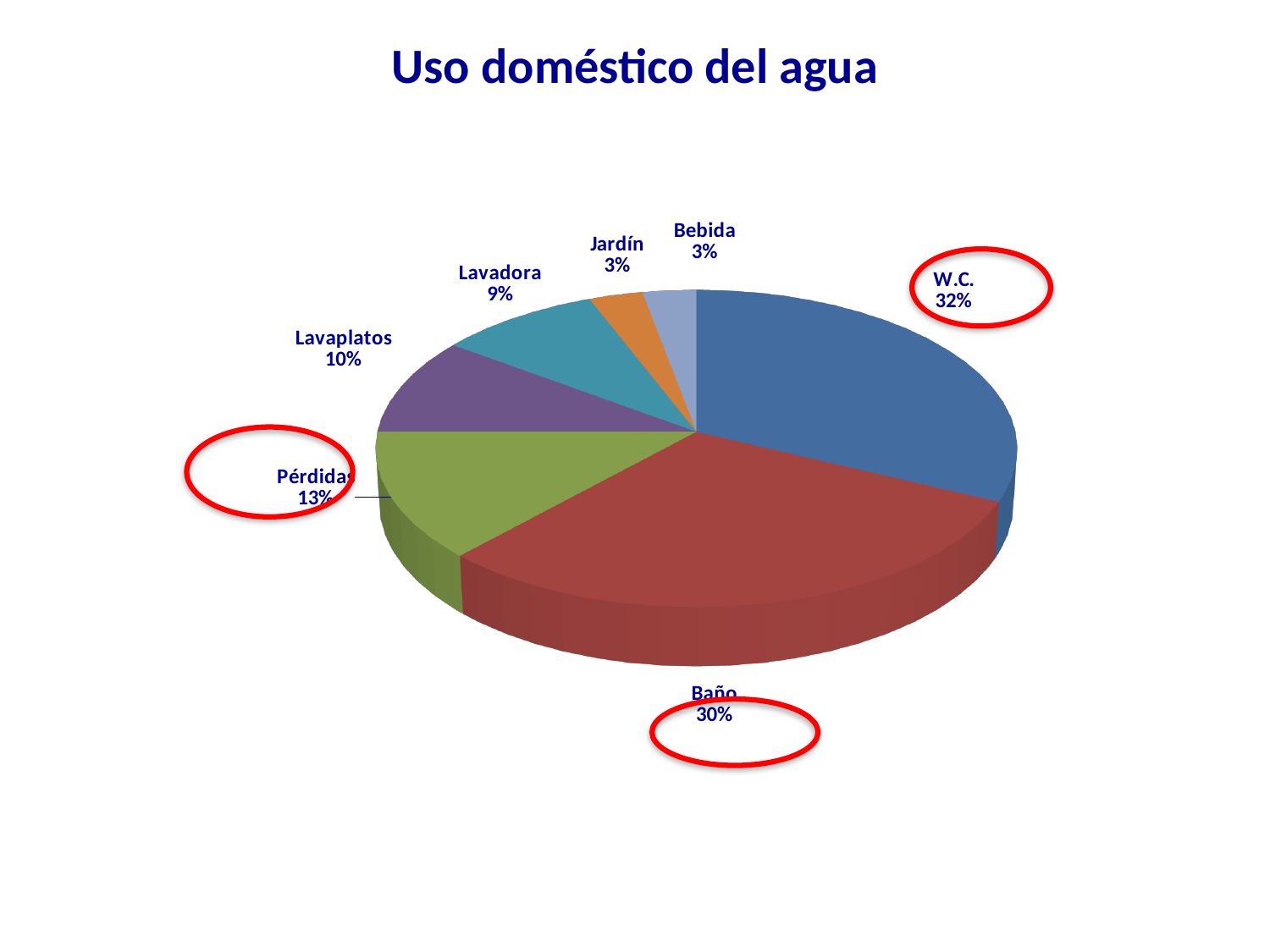
What is the value shown for Baño? 30% What is the title of the chart? Uso doméstico del agua Which three slices are circled in red on the slide? W.C., Pérdidas, Baño What kind of chart is shown on the slide? pie chart What is the difference between the shares of W.C. and Baño? 2% Which is larger, the share for Pérdidas or the share for Lavaplatos? Pérdidas What is the value shown for Lavadora? 9% What is the value shown for Pérdidas? 13% What share of the pie does W.C. represent? 32% Which category has the largest share of the pie? W.C. What is the value shown for Lavaplatos? 10% How many categories (slices) does the pie chart have? 7